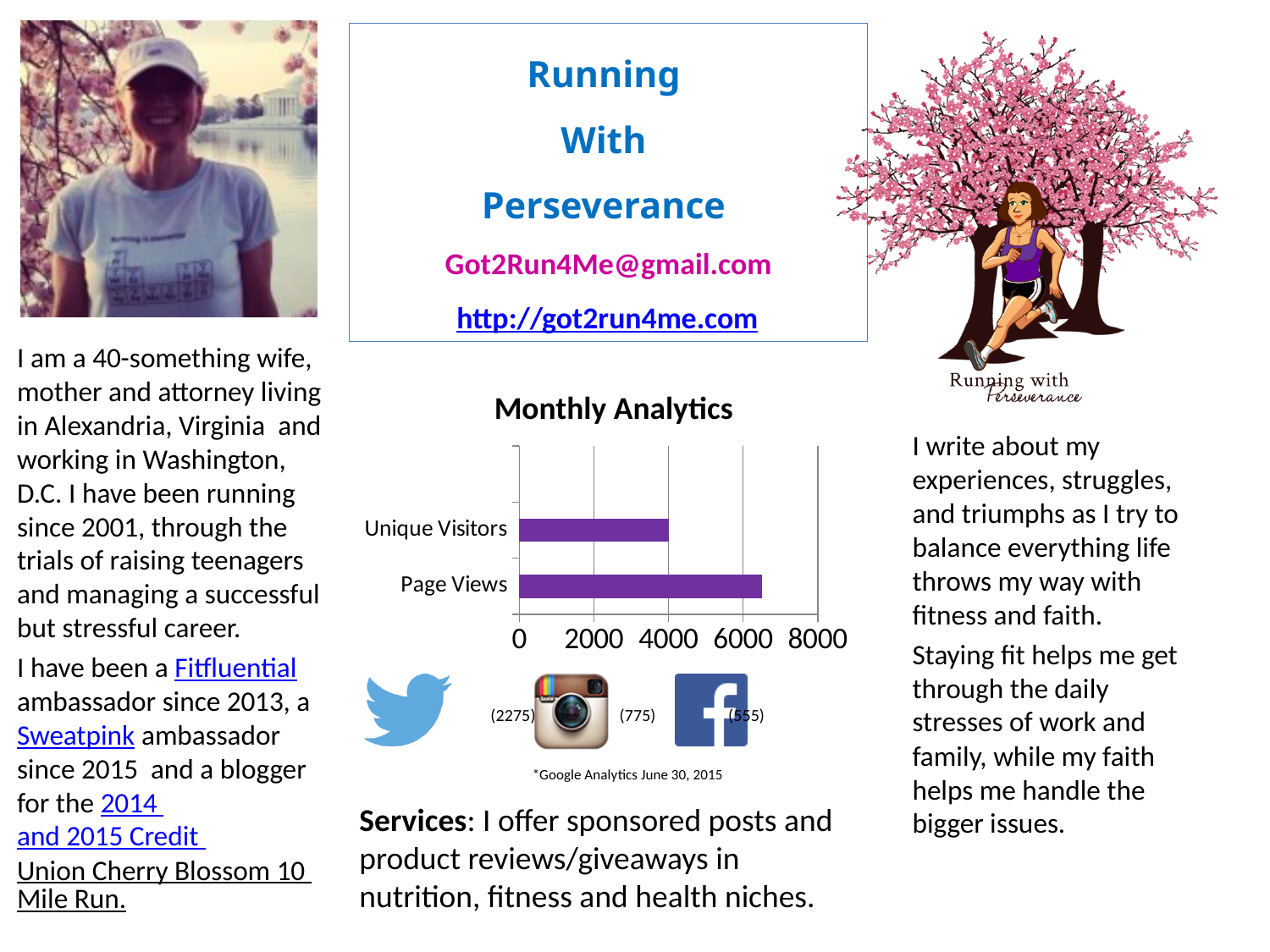
In the Monthly Analytics chart, is the value for Page Views greater or less than 6000? greater How many categories are plotted in the Monthly Analytics chart? 2 Which category has the highest value in the Monthly Analytics chart? Page Views Which category has the lowest value in the Monthly Analytics chart? Unique Visitors In the Monthly Analytics chart, is the value for Unique Visitors greater or less than 2000? greater What is the title of the chart on the slide? Monthly Analytics In the Monthly Analytics chart, is the value for Page Views greater or less than 8000? less What kind of chart is shown under the title "Monthly Analytics"? bar chart What is the highest value shown on the horizontal axis of the Monthly Analytics chart? 8000 In the Monthly Analytics chart, which is larger: Page Views or Unique Visitors? Page Views